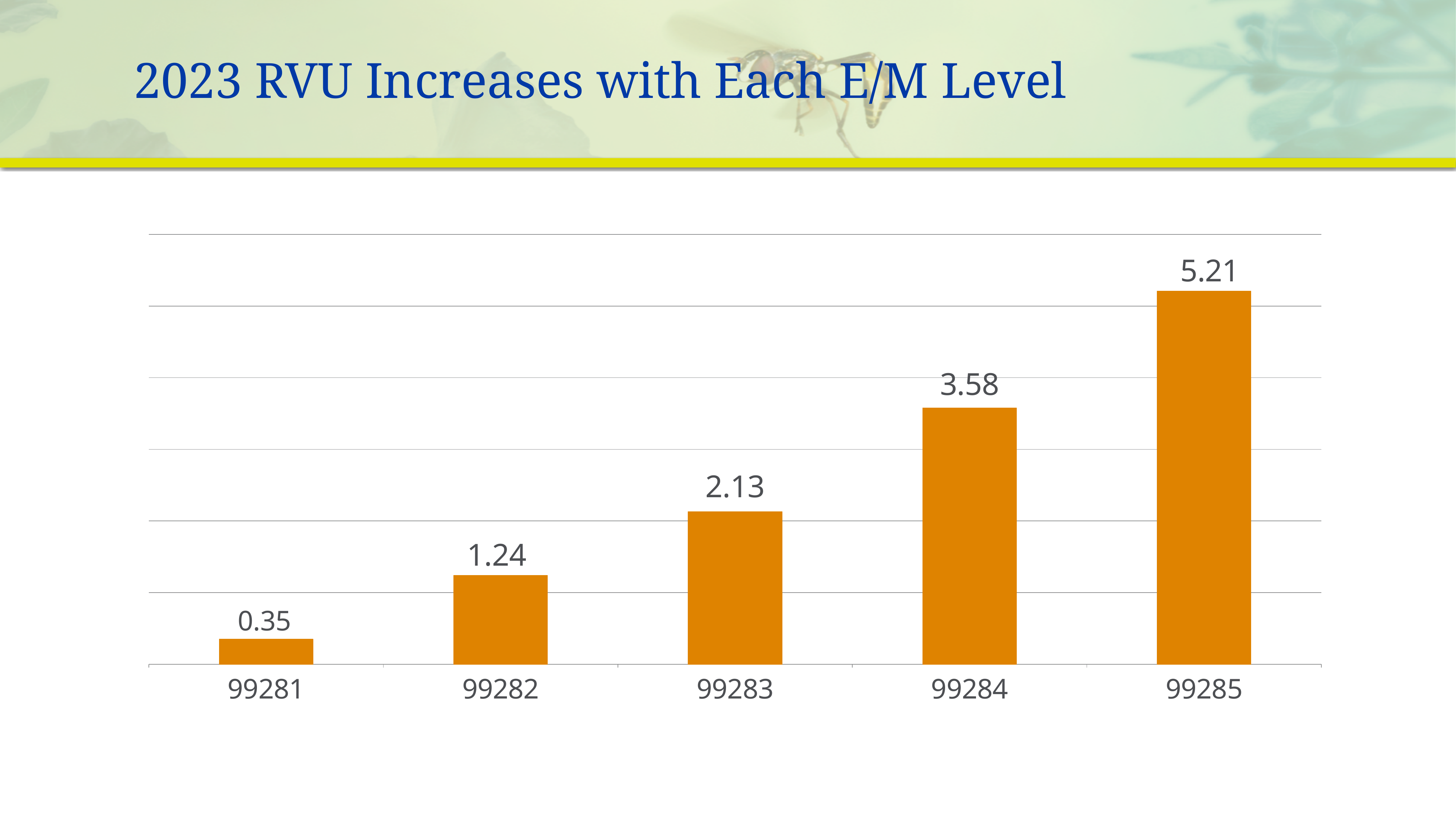
Do the RVU values rise or fall from 99281 to 99285? Rise What kind of chart is shown on the slide? Bar chart What is the RVU value for 99285? 5.21 What is the difference between the RVU values for 99282 and 99281? 0.89 What is the RVU value for 99281? 0.35 Which E/M code has the lowest RVU value? 99281 What is the difference between the RVU values for 99285 and 99284? 1.63 What is the title of the slide? 2023 RVU Increases with Each E/M Level Which has a larger RVU value, 99283 or 99284? 99284 How many E/M codes are shown on the chart? 5 What is the RVU value for 99283? 2.13 Which E/M code has the highest RVU value? 99285